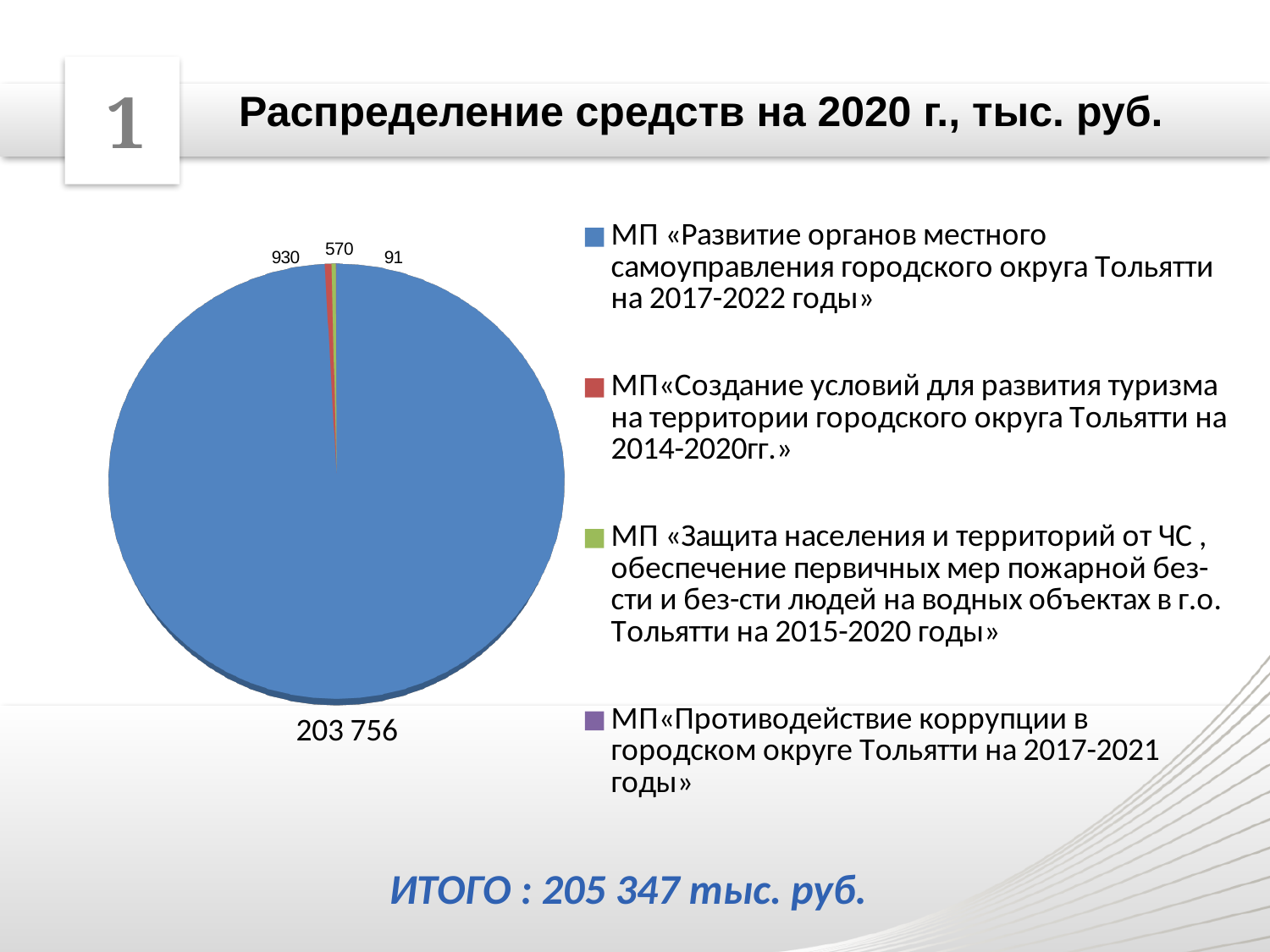
What is the value for МП«Противодействие коррупции в городском округе Тольятти на 2017-2021 годы»? 91 Which programme has the largest slice of the pie? МП «Развитие органов местного самоуправления городского округа Тольятти на 2017-2022 годы» How many slices does the pie chart have? 4 What is the value for МП «Развитие органов местного самоуправления городского округа Тольятти на 2017-2022 годы»? 203 756 What is the value for МП «Защита населения и территорий от ЧС, обеспечение первичных мер пожарной без-сти и без-сти людей на водных объектах в г.о. Тольятти на 2015-2020 годы»? 570 What total amount is stated on the slide (ИТОГО)? 205 347 тыс. руб. What is the difference between the value for the tourism programme (930) and the value for the civil protection programme (570)? 360 What is the value for МП«Создание условий для развития туризма на территории городского округа Тольятти на 2014-2020гг.»? 930 What kind of chart is shown on the slide? pie chart What is the title of the slide's chart? Распределение средств на 2020 г., тыс. руб. Which is larger: the value for the tourism programme or the value for the anti-corruption programme? the tourism programme (930) Which programme has the smallest slice of the pie? МП«Противодействие коррупции в городском округе Тольятти на 2017-2021 годы»